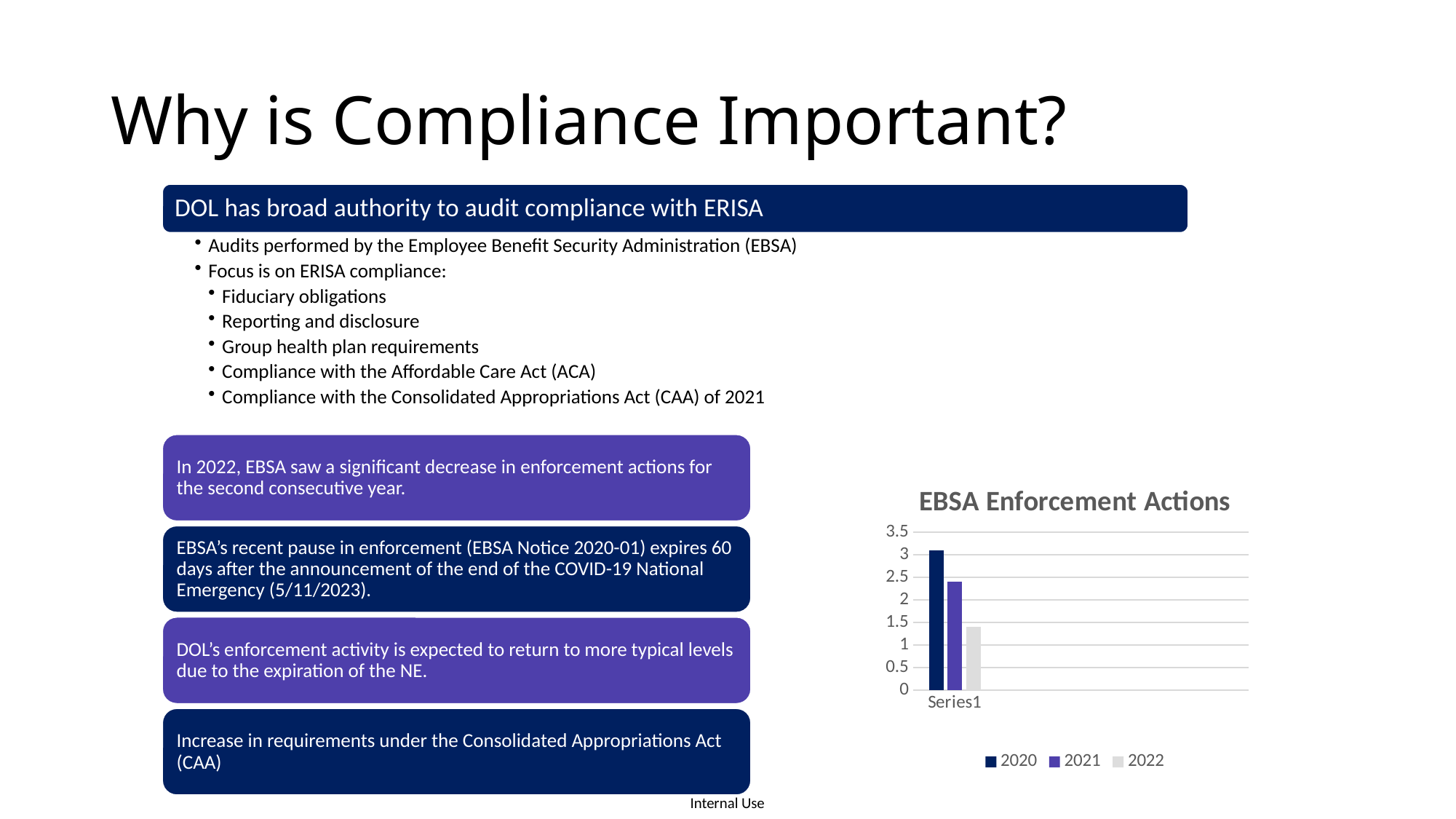
Is the value for 2020 greater or less than 2.5? greater Which is larger in the chart, the value for 2020 or the value for 2022? 2020 Is the value for 2022 greater or less than 1? greater Which year has the highest bar in the EBSA Enforcement Actions chart? 2020 How many series does the chart's legend list? 3 What is the title of the chart? EBSA Enforcement Actions Which year has the lowest bar in the EBSA Enforcement Actions chart? 2022 Which is larger in the chart, the value for 2021 or the value for 2022? 2021 How many categories are shown on the x axis of the chart? 1 Is the value for 2021 greater or less than 2? greater Do the bar values rise or fall from 2020 to 2022 in the chart? fall What kind of chart is shown on the slide? bar chart